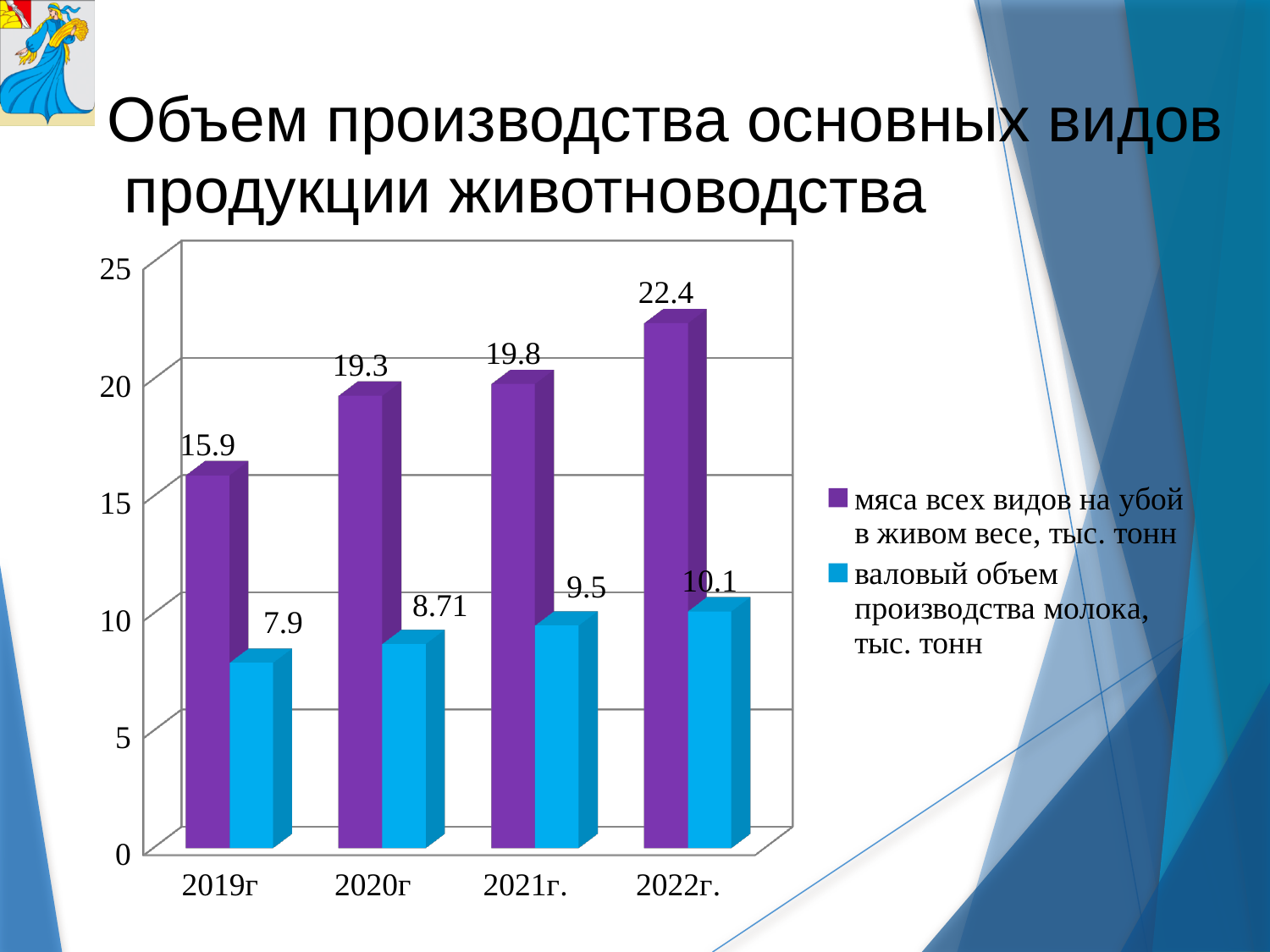
How many series does the legend list? 2 How many years are shown on the x axis? 4 Which is larger in 2021г.: meat production or milk production? meat production (мяса всех видов на убой в живом весе) What is the value for milk production in 2019г? 7.9 What is the difference between meat production in 2022г. and in 2019г? 6.5 In which year is milk production (валовый объем производства молока) lowest? 2019г In which year is meat production (мяса всех видов на убой в живом весе) highest? 2022г. Does meat production rise or fall from 2019г to 2022г.? rise What kind of chart is shown on the slide? bar chart What is the value for meat of all kinds for slaughter in live weight (мяса всех видов на убой в живом весе) in 2022г.? 22.4 What is the gross volume of milk production (валовый объем производства молока) in 2020г? 8.71 What is the difference between milk production in 2021г. and in 2020г? 0.79